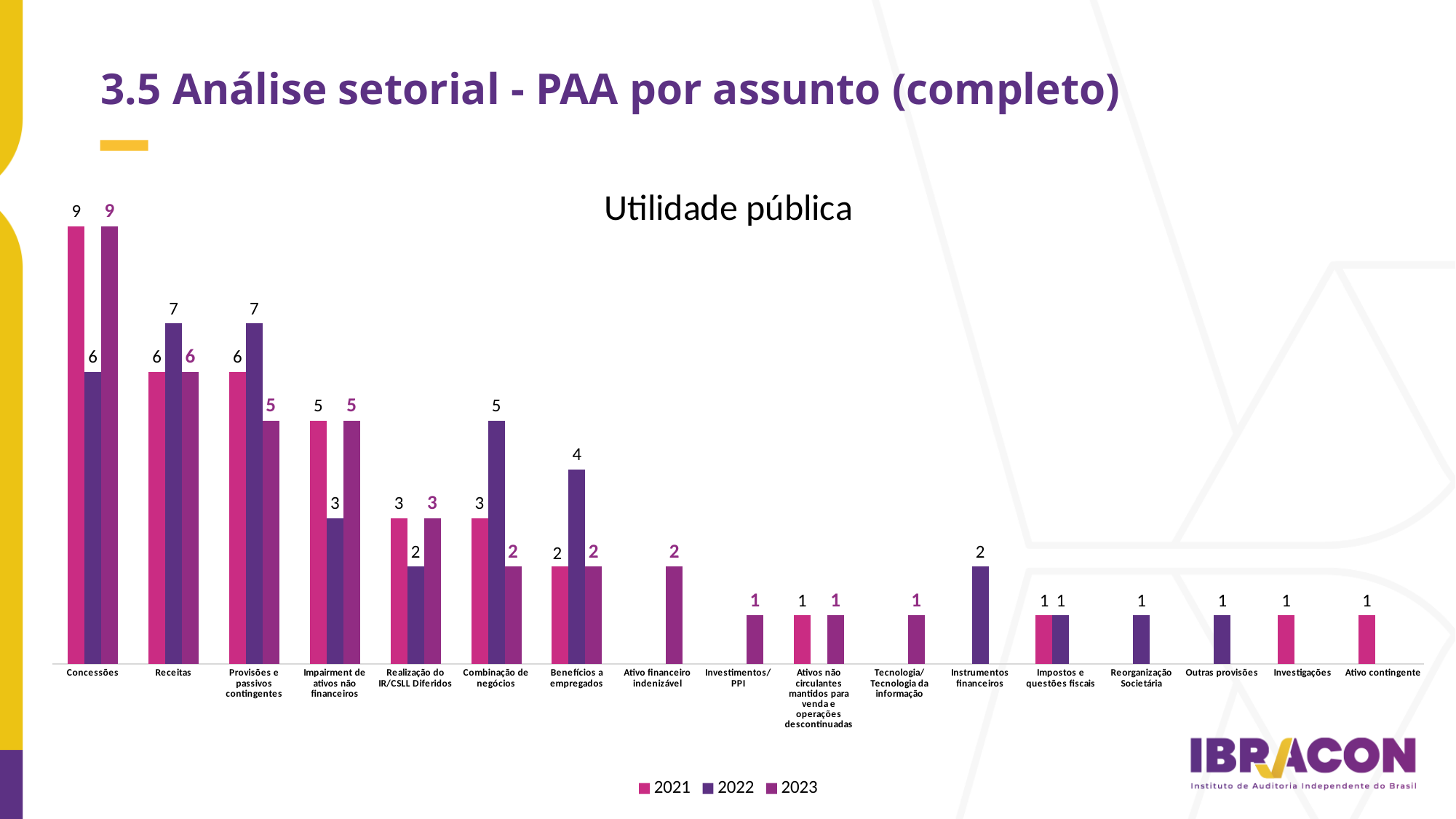
What is the 2023 value for Provisões e passivos contingentes? 5 What is the 2023 value for Ativo financeiro indenizável? 2 Which category has the highest 2022 value? Receitas and Provisões e passivos contingentes (7 each) What is the title of the chart? Utilidade pública How many series does the legend list? 3 What is the total of the 2021, 2022 and 2023 values for Receitas? 19 How many categories are shown on the x axis? 17 What is the difference between the 2022 and 2021 values for Combinação de negócios? 2 What kind of chart is shown on the slide? Bar chart Which is larger for Impairment de ativos não financeiros: the 2021 value or the 2022 value? 2021 What is the 2022 value for Concessões? 6 What is the 2022 value for Benefícios a empregados? 4